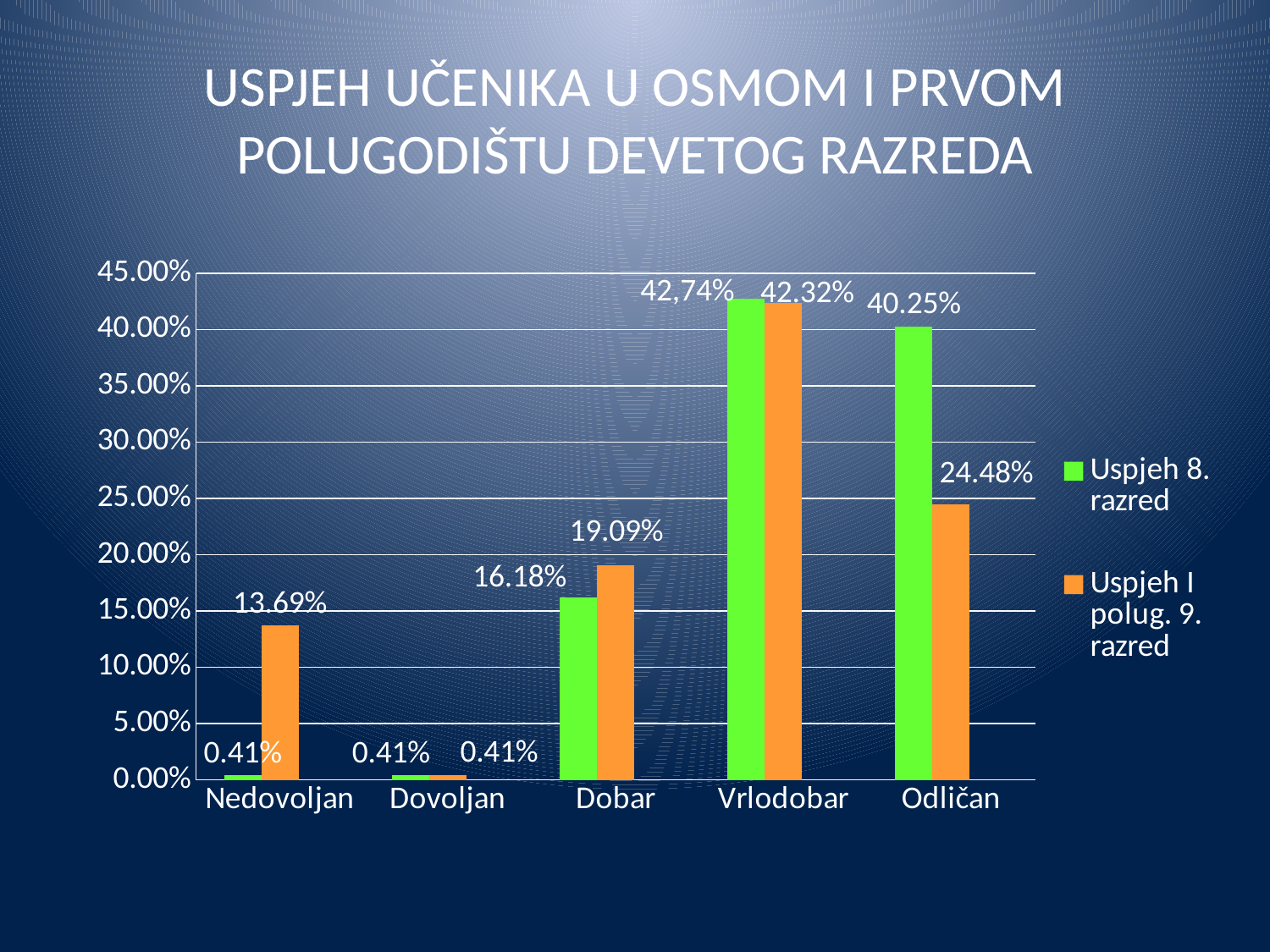
Which category has the lowest value in the Uspjeh I polug. 9. razred series? Dovoljan What is the value for Dobar in the Uspjeh I polug. 9. razred series? 19.09% How many series does the legend list? 2 Which category has the highest value in the Uspjeh I polug. 9. razred series? Vrlodobar What kind of chart is shown on the slide? Bar chart What is the value for Nedovoljan in the Uspjeh I polug. 9. razred series? 13.69% What is the value for Vrlodobar in the Uspjeh 8. razred series? 42,74% For Dobar, which series has the larger value, Uspjeh 8. razred or Uspjeh I polug. 9. razred? Uspjeh I polug. 9. razred What is the difference between the Uspjeh 8. razred and Uspjeh I polug. 9. razred values for Odličan? 15.77% What is the value for Odličan in the Uspjeh 8. razred series? 40.25% What is the difference between the Uspjeh I polug. 9. razred and Uspjeh 8. razred values for Dobar? 2.91% How many categories are shown on the x axis? 5